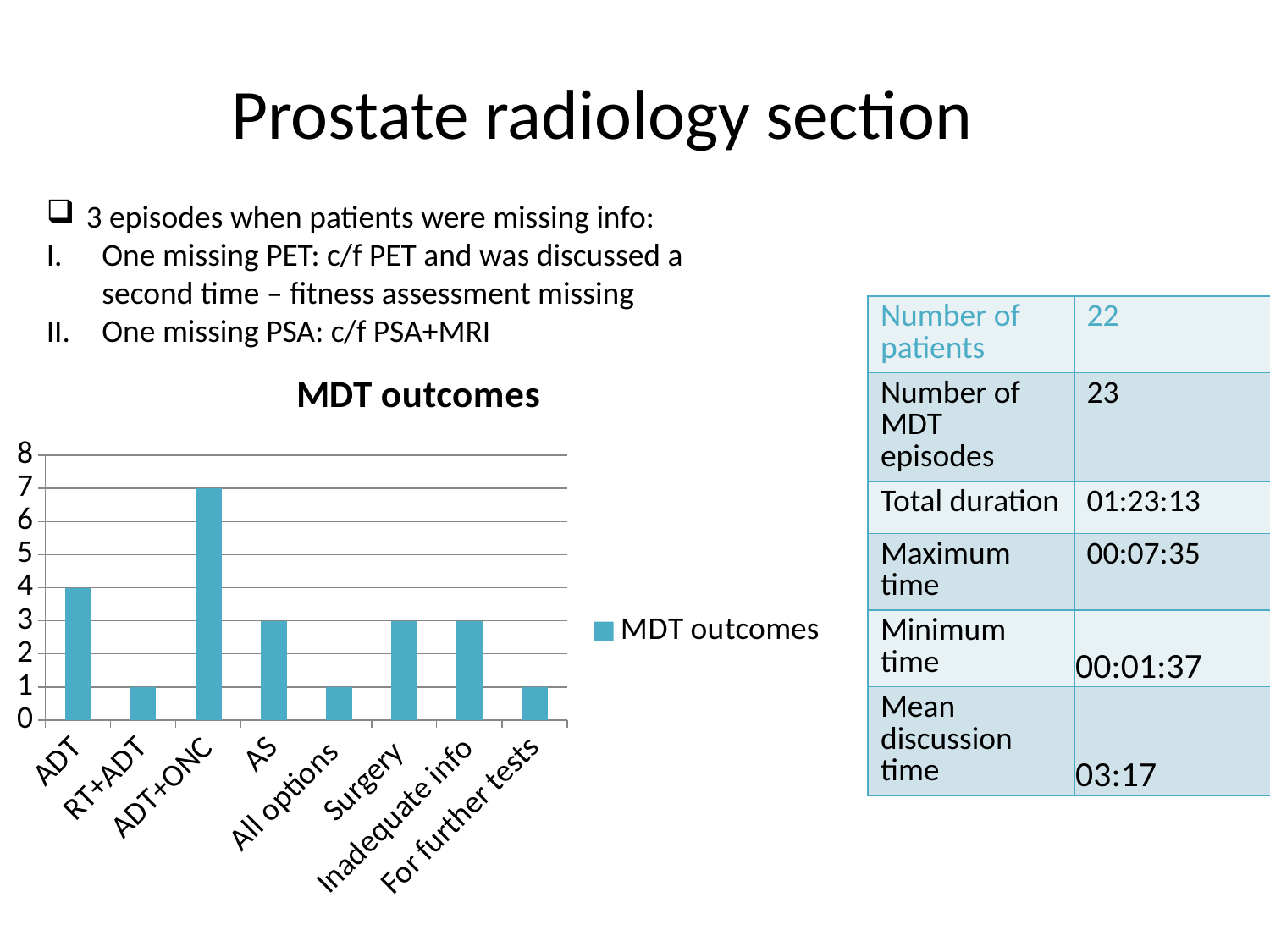
How many series does the legend of the MDT outcomes chart list? 1 In the MDT outcomes chart, is the value for ADT+ONC greater or less than 6? greater In the MDT outcomes chart, what is the difference between the values for ADT+ONC and ADT? 3 In the MDT outcomes chart, what is the value for Surgery? 3 In the MDT outcomes chart, which is larger, the value for AS or the value for All options? AS What type of chart is shown under the title "MDT outcomes"? bar chart In the MDT outcomes chart, which category has the highest value? ADT+ONC What is the title of the bar chart on the slide? MDT outcomes In the MDT outcomes chart, what is the value for ADT+ONC? 7 In the MDT outcomes chart, what is the value for RT+ADT? 1 How many categories are shown on the x axis of the MDT outcomes chart? 8 In the MDT outcomes chart, what is the value for ADT? 4